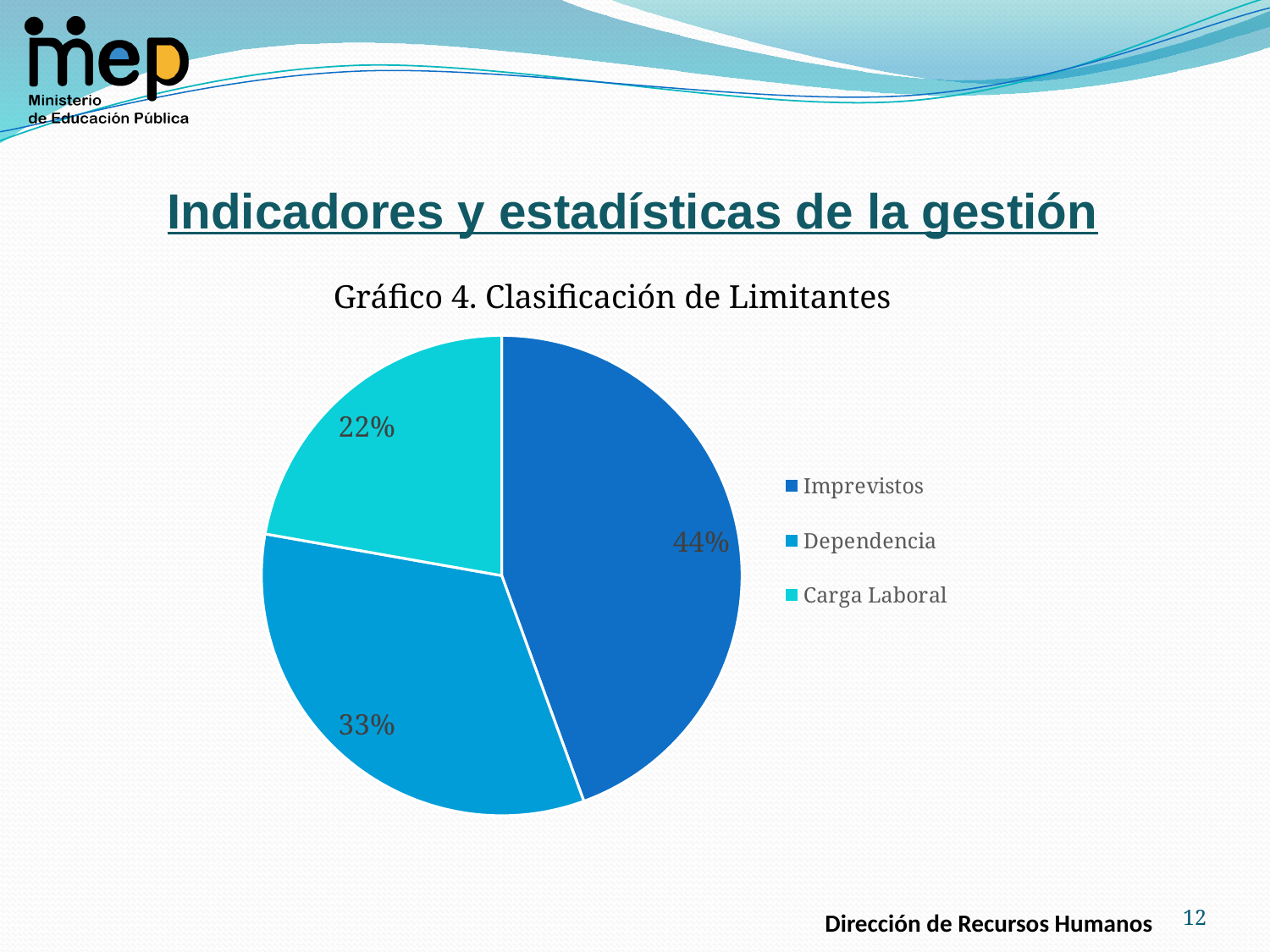
What share of the pie does Carga Laboral represent? 22% Which category has the largest slice of the pie? Imprevistos How many categories does the pie chart show? 3 What is the title of the chart? Gráfico 4. Clasificación de Limitantes What is the difference in percentage points between Imprevistos and Carga Laboral? 22 Which category has the smallest slice of the pie? Carga Laboral What share of the pie does Dependencia represent? 33% What kind of chart is shown on the slide? pie chart How many entries does the legend list? 3 What is the difference in percentage points between Imprevistos and Dependencia? 11 Which is larger, the share for Dependencia or the share for Carga Laboral? Dependencia What share of the pie does Imprevistos represent? 44%